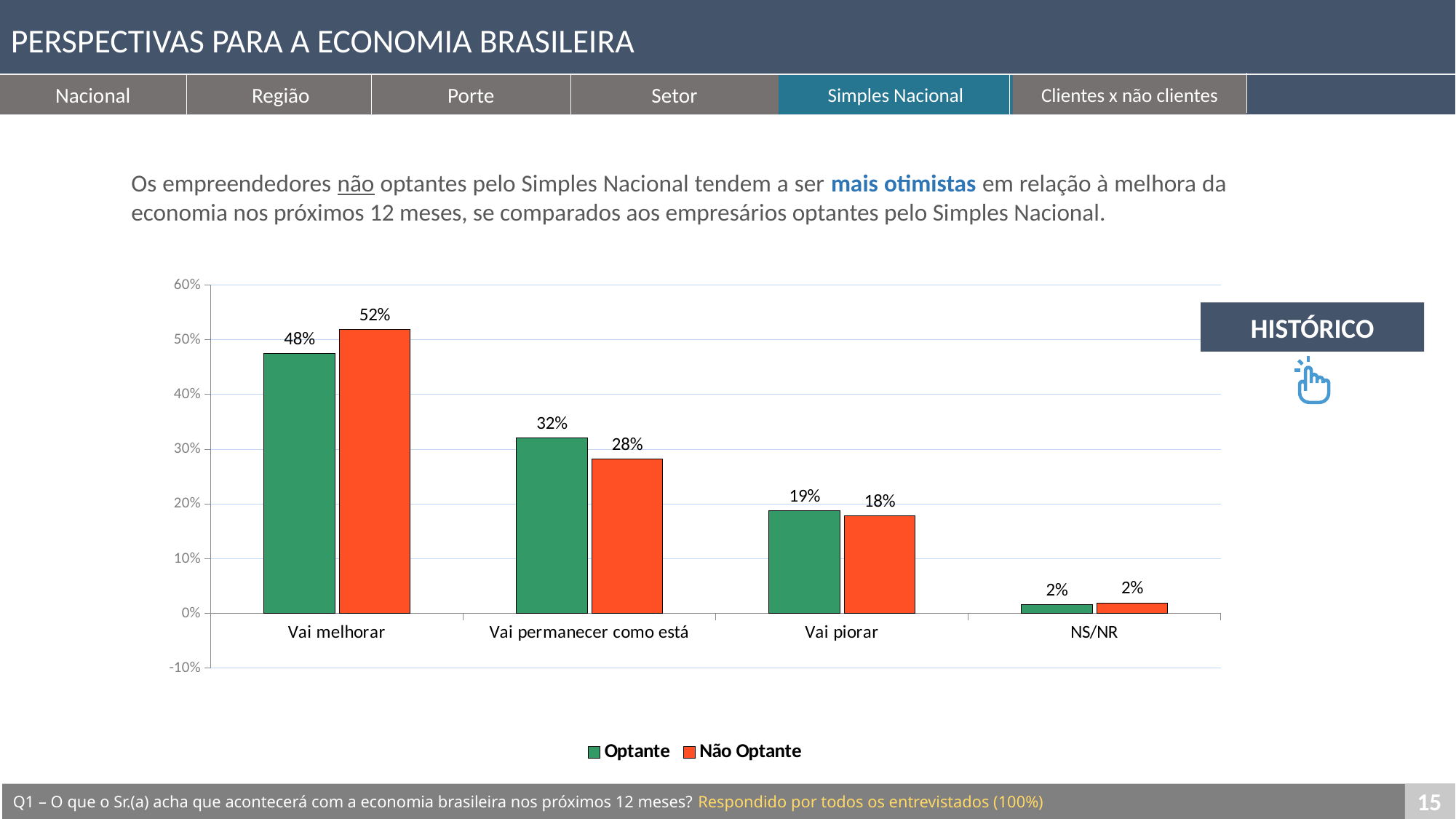
Which category has the highest value for the Não Optante series? Vai melhorar How many categories are shown on the x axis of the chart? 4 What kind of chart is shown on the slide? Bar chart In the 'Vai melhorar' category, which series has the larger value, Optante or Não Optante? Não Optante What is the value for Optante in the 'Vai permanecer como está' category? 32% What is the difference between the Optante and Não Optante values in the 'Vai permanecer como está' category? 4% Which category has the lowest value for the Optante series? NS/NR What is the value for Não Optante in the 'Vai melhorar' category? 52% What is the value for Optante in the 'Vai melhorar' category? 48% How many series does the legend list? 2 What is the value for Não Optante in the 'Vai piorar' category? 18% Which colour represents the Não Optante series in the chart? Orange